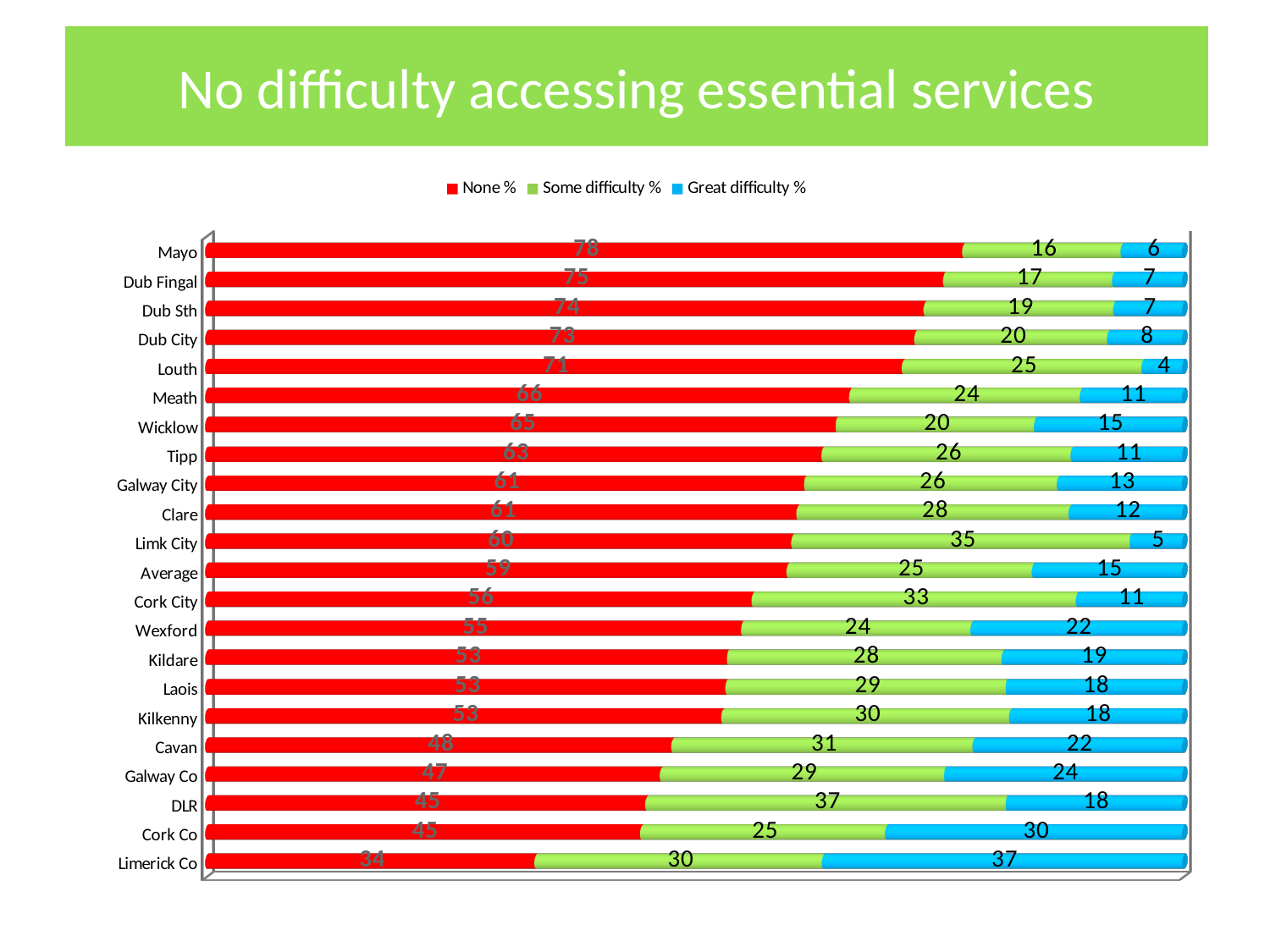
How many series does the legend list? 3 What is the Some difficulty % value for DLR? 37 Which has the larger Great difficulty % value, Cork Co or Galway Co? Cork Co What is the total of the three values in the Cork Co bar? 100 Which category has the highest None % value? Mayo Which category has the lowest None % value? Limerick Co How many categories are shown on the chart? 22 What is the difference between the None % values for Mayo and Limerick Co? 44 What is the Great difficulty % value for Limerick Co? 37 Which category has the lowest Great difficulty % value? Louth What kind of chart is shown on the slide? stacked bar chart What is the None % value for Mayo? 78